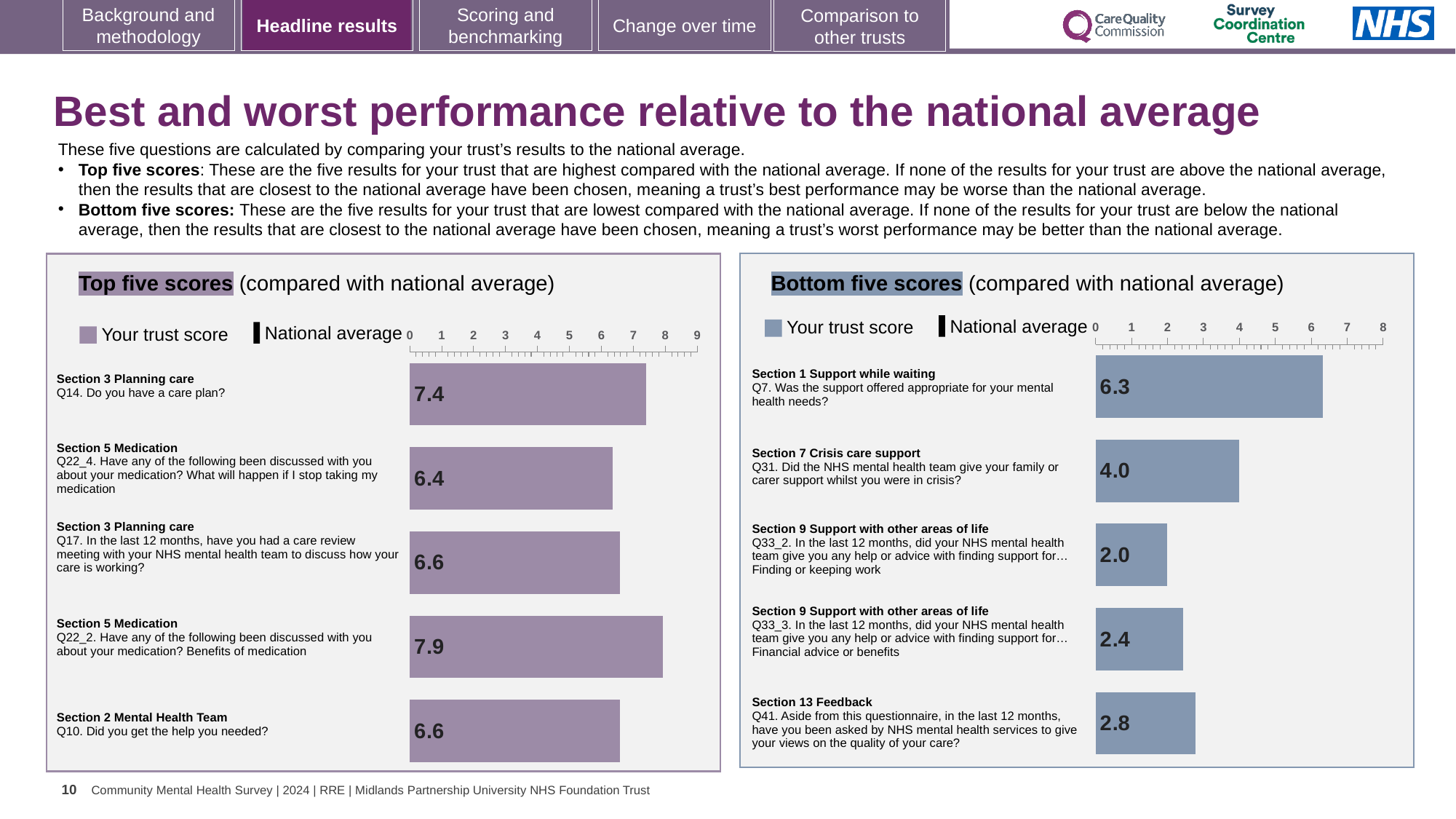
In the Top five scores chart, which question has the lowest trust score? Q22_4. Have any of the following been discussed with you about your medication? What will happen if I stop taking my medication What type of chart is used in the Top five scores panel? Bar chart In the Top five scores chart, what is the difference between the trust scores for Q22_2 and Q22_4? 1.5 In the Bottom five scores chart, what is the highest value shown on the axis? 8 In the Bottom five scores chart, is the trust score for Q41 larger or smaller than the trust score for Q33_3? larger In the Bottom five scores chart, what is the difference between the trust scores for Q7 and Q33_2? 4.3 In the Top five scores chart, how many questions are plotted? 5 In the Bottom five scores chart, which question has the highest trust score? Q7. Was the support offered appropriate for your mental health needs? In the Top five scores chart, which question has the highest trust score? Q22_2. Have any of the following been discussed with you about your medication? Benefits of medication In the Top five scores chart, what is the trust score for Q14 (Do you have a care plan?)? 7.4 In the Bottom five scores chart, what is the trust score for Q31 (Did the NHS mental health team give your family or carer support whilst you were in crisis?)? 4.0 In the Bottom five scores chart, which question has the lowest trust score? Q33_2. In the last 12 months, did your NHS mental health team give you any help or advice with finding support for… Finding or keeping work